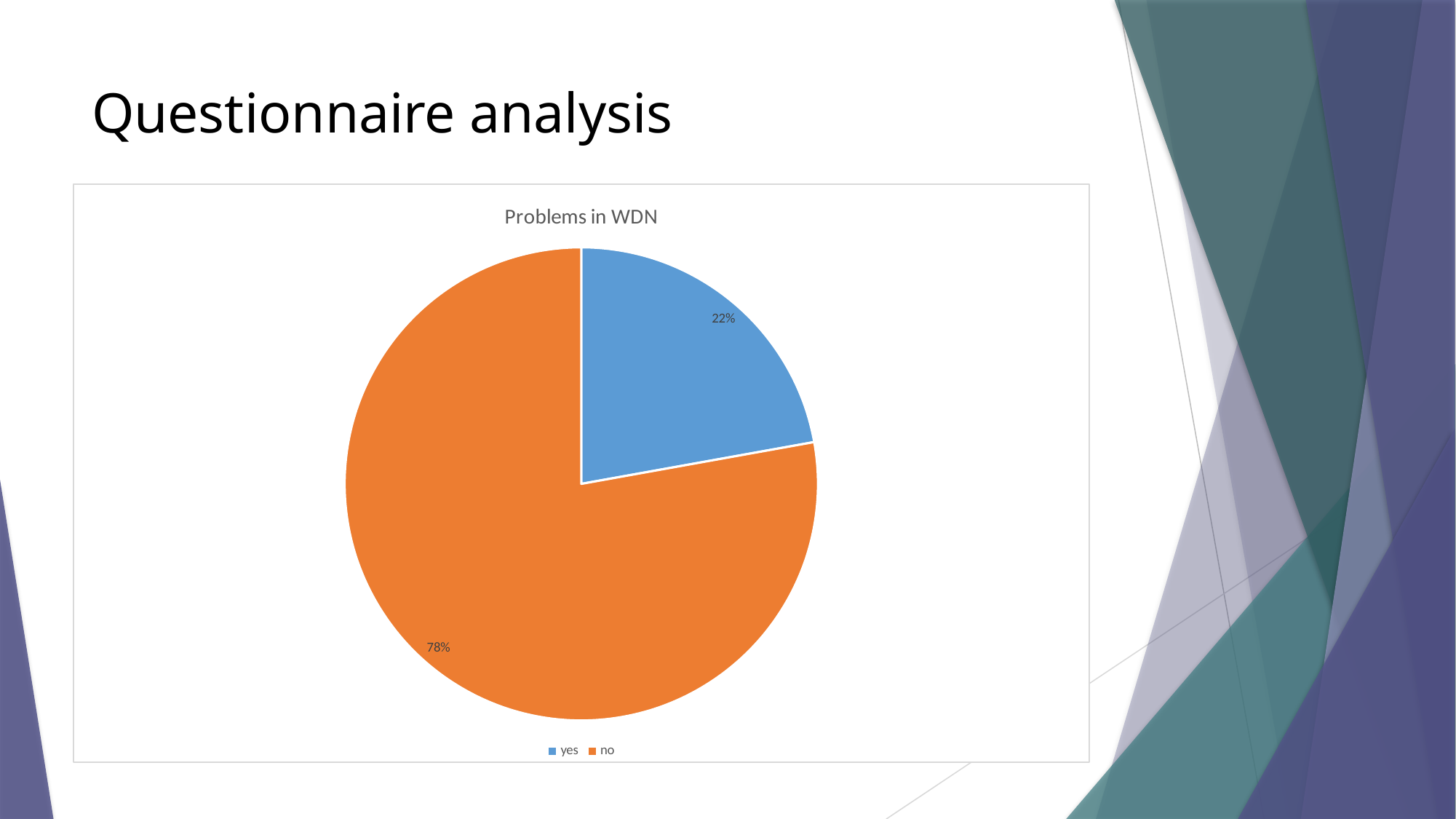
What is the title of the chart? Problems in WDN What share of the pie does the "yes" slice represent? 22% Which category has the smallest slice of the pie? yes What colour is the "no" slice? orange How many categories does the pie chart show? 2 How many entries does the legend list? 2 What kind of chart is shown on the slide? pie chart Which category has the largest slice of the pie? no What is the difference in percentage points between the "no" slice and the "yes" slice? 56% Which is larger, the "yes" slice or the "no" slice? no What share of the pie does the "no" slice represent? 78%